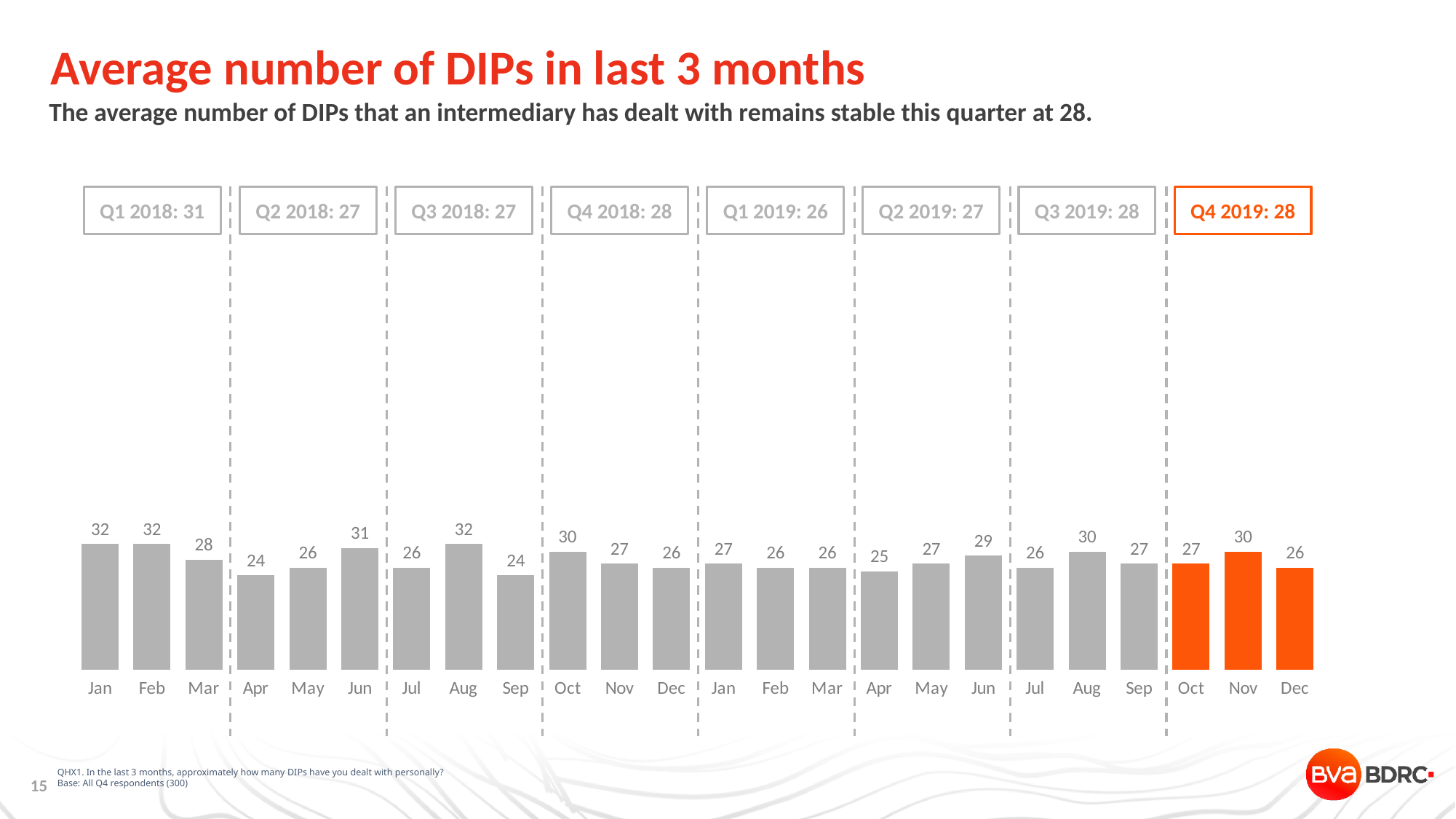
What is the value for Nov 2019? 30 What is the lowest monthly value shown in the chart? 24 What kind of chart is shown on the slide? Bar chart How many monthly bars are plotted in the chart? 24 Do the values rise or fall from Jan 2018 to Mar 2018? Fall Which is larger, the value for Oct 2018 or the value for Oct 2019? Oct 2018 What is the value for Apr 2019? 25 What is the quarterly average shown for Q1 2018? 31 What is the difference between the values for Jun 2018 and Apr 2018? 7 Which quarter's bars are highlighted in orange? Q4 2019 What is the highest monthly value shown in the chart? 32 What is the value for Aug 2018? 32